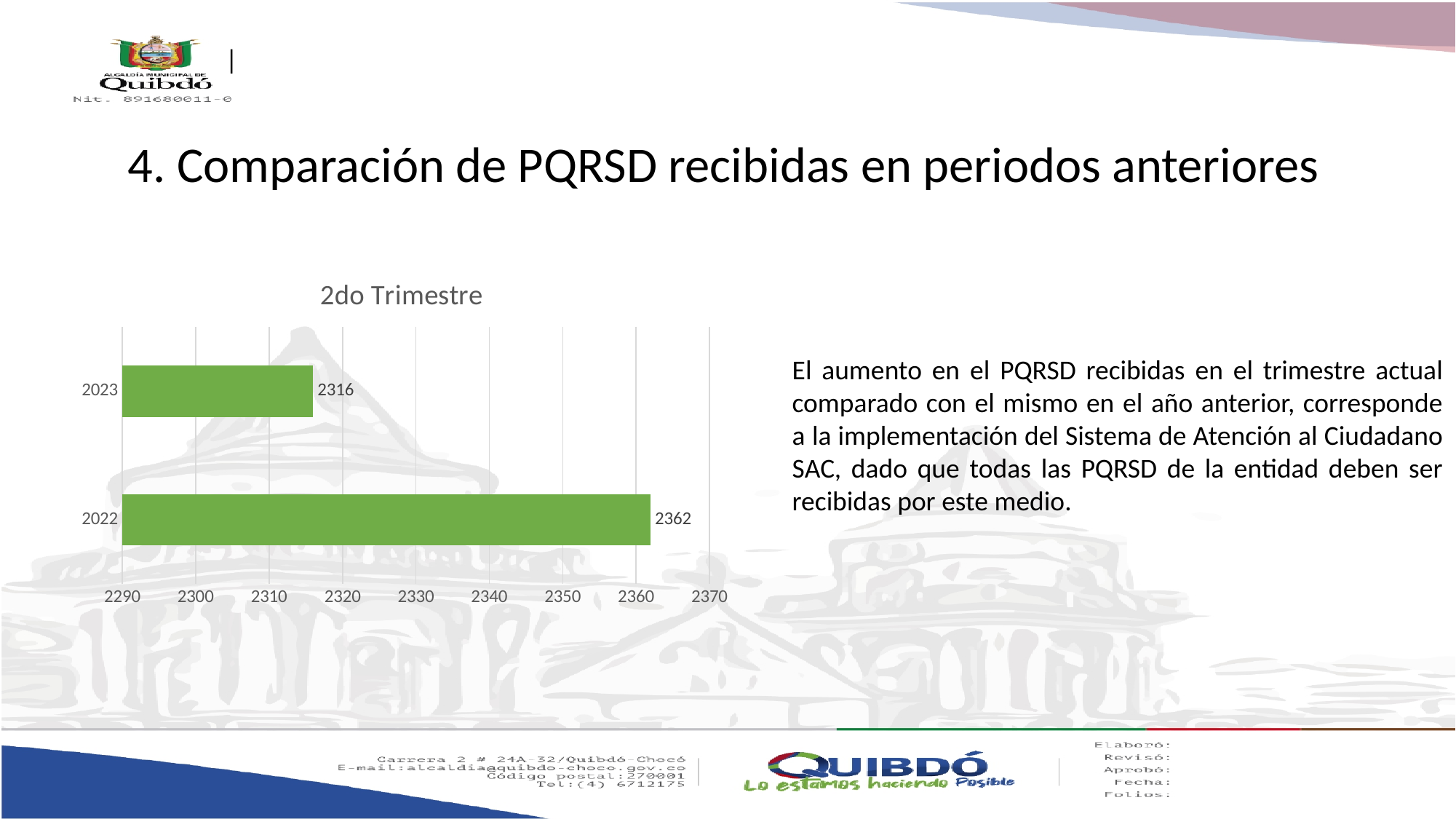
Which year has the lowest value in the chart? 2023 What is the value for 2023 in the chart? 2316 Is the value for 2023 greater or less than 2320? less What is the value for 2022 in the chart? 2362 Is the value for 2022 greater or less than 2350? greater What is the difference between the values for 2022 and 2023? 46 What colour are the bars in the chart? green What kind of chart is shown on the slide? bar chart Which year has the highest value in the chart? 2022 How many categories (years) are shown in the chart? 2 Which is larger, the value for 2022 or the value for 2023? 2022 What is the title of the chart? 2do Trimestre